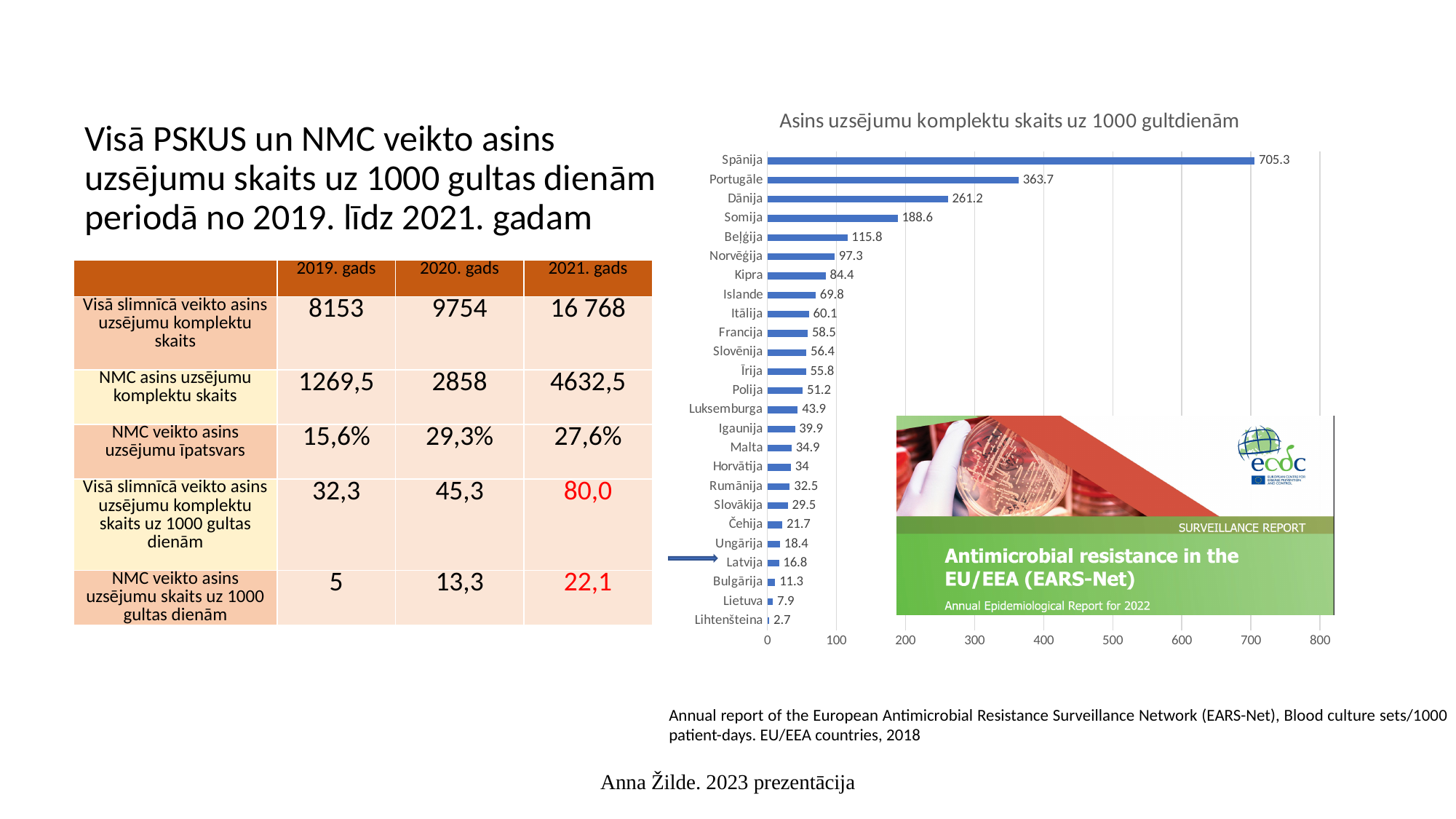
Is the value for Beļģija greater or less than 100? greater What is the value for Somija in the chart? 188.6 What is the value for Latvija in the chart? 16.8 What is the value for Spānija in the chart? 705.3 Which has a larger value, Dānija or Somija? Dānija Which country has the lowest value in the chart? Lihtenšteina What is the title of the chart? Asins uzsējumu komplektu skaits uz 1000 gultdienām What is the difference between the values for Latvija and Lietuva? 8.9 What is the difference between the values for Spānija and Portugāle? 341.6 How many countries are shown in the chart? 25 Which country has the highest value in the chart? Spānija What kind of chart is shown on the slide? bar chart